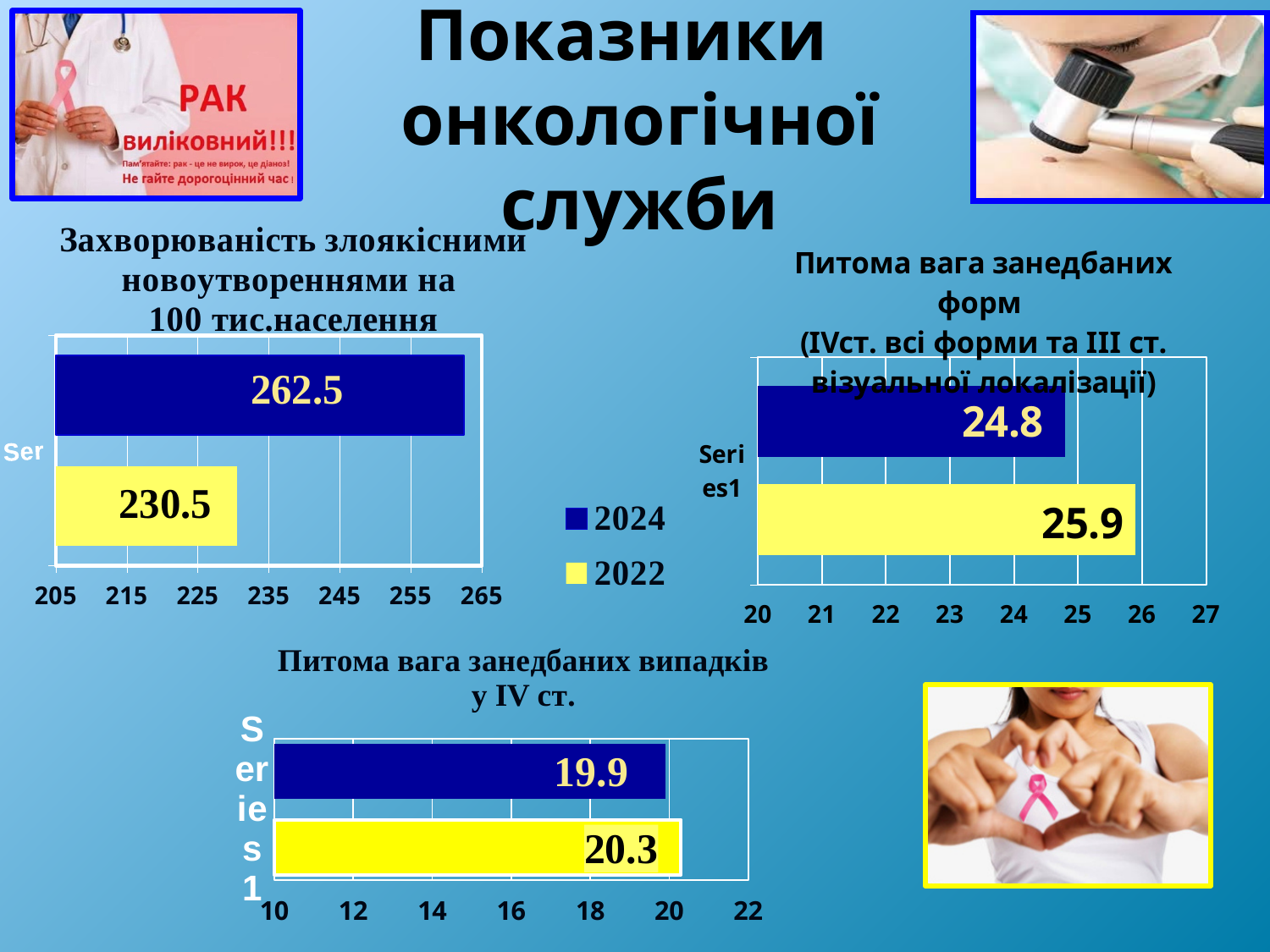
On the chart titled "Питома вага занедбаних випадків у IV ст." (bottom), what is the value of the yellow (2022) bar? 20.3 What kind of chart is the chart titled "Захворюваність злоякісними новоутвореннями на 100 тис.населення"? Bar chart How many series does the legend in the middle of the slide list? 2 On the chart titled "Захворюваність злоякісними новоутвореннями на 100 тис.населення", which bar is larger, 2024 or 2022? 2024 On the chart titled "Питома вага занедбаних випадків у IV ст." (bottom), what is the value of the dark blue (2024) bar? 19.9 On the chart titled "Питома вага занедбаних випадків у IV ст." (bottom), what is the difference between the 2022 and 2024 values? 0.4 On the chart titled "Питома вага занедбаних форм" (top right), which year has the higher value? 2022 On the chart titled "Захворюваність злоякісними новоутвореннями на 100 тис.населення", what is the value of the yellow (2022) bar? 230.5 On the chart titled "Питома вага занедбаних форм" (top right), what is the value of the yellow (2022) bar? 25.9 On the chart titled "Захворюваність злоякісними новоутвореннями на 100 тис.населення", what is the difference between the 2024 and 2022 values? 32 On the chart titled "Захворюваність злоякісними новоутвореннями на 100 тис.населення", what is the value of the dark blue (2024) bar? 262.5 On the chart titled "Питома вага занедбаних форм" (top right), what is the value of the dark blue (2024) bar? 24.8